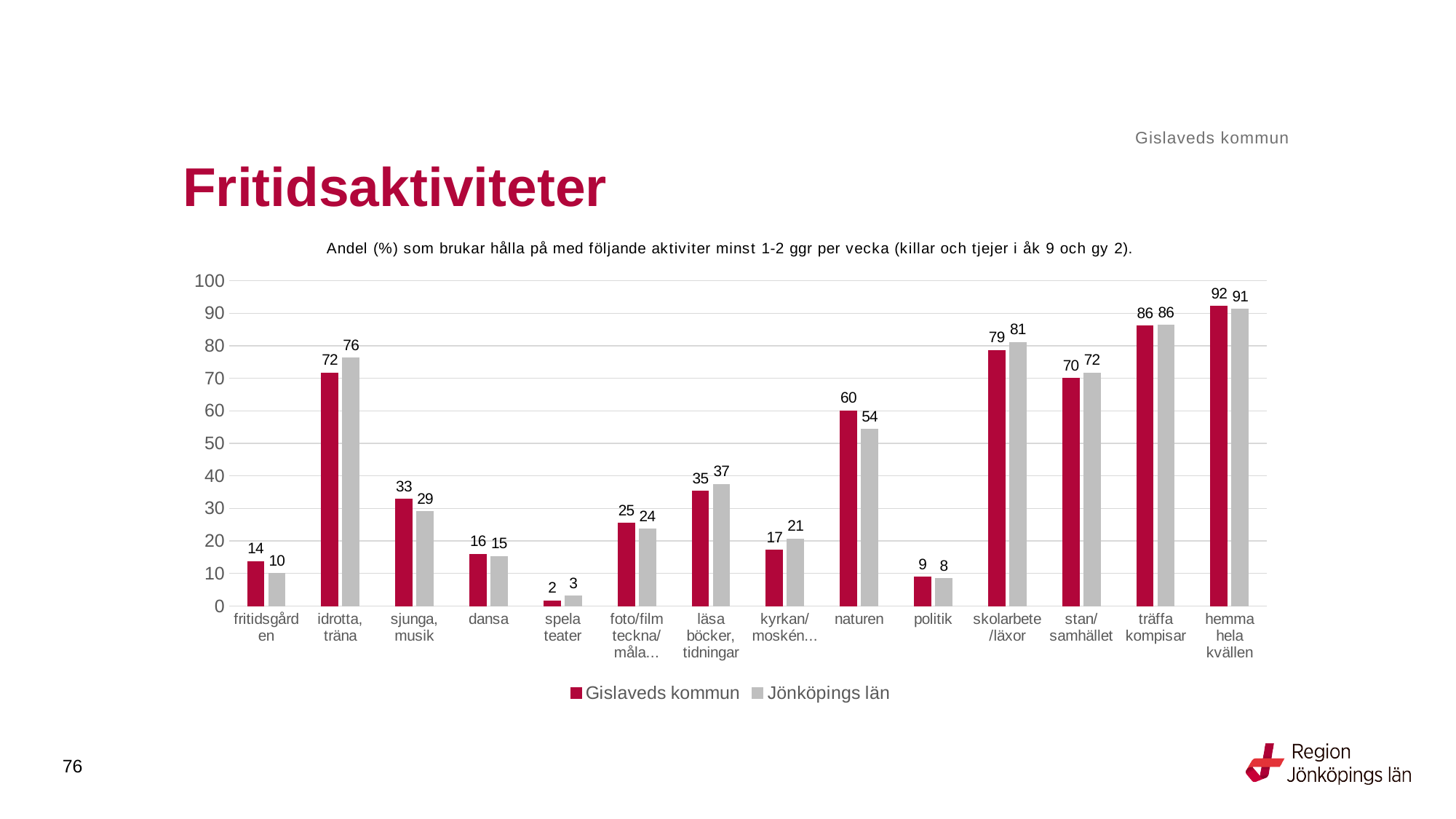
Which colour represents Gislaveds kommun in the chart? red What is the difference between Gislaveds kommun and Jönköpings län for 'naturen'? 6 How many activity categories are shown on the x axis? 14 Is the value for Gislaveds kommun for 'skolarbete/läxor' greater or less than 70? greater How many series does the legend list? 2 What is the value for Jönköpings län for 'politik'? 8 What is the value for Jönköpings län for 'idrotta, träna'? 76 Which is larger for 'kyrkan/moskén…': Gislaveds kommun or Jönköpings län? Jönköpings län Which category has the highest value for Gislaveds kommun? hemma hela kvällen What is the value for Gislaveds kommun for 'naturen'? 60 What kind of chart is shown on the slide? bar chart Which category has the lowest value for Jönköpings län? spela teater